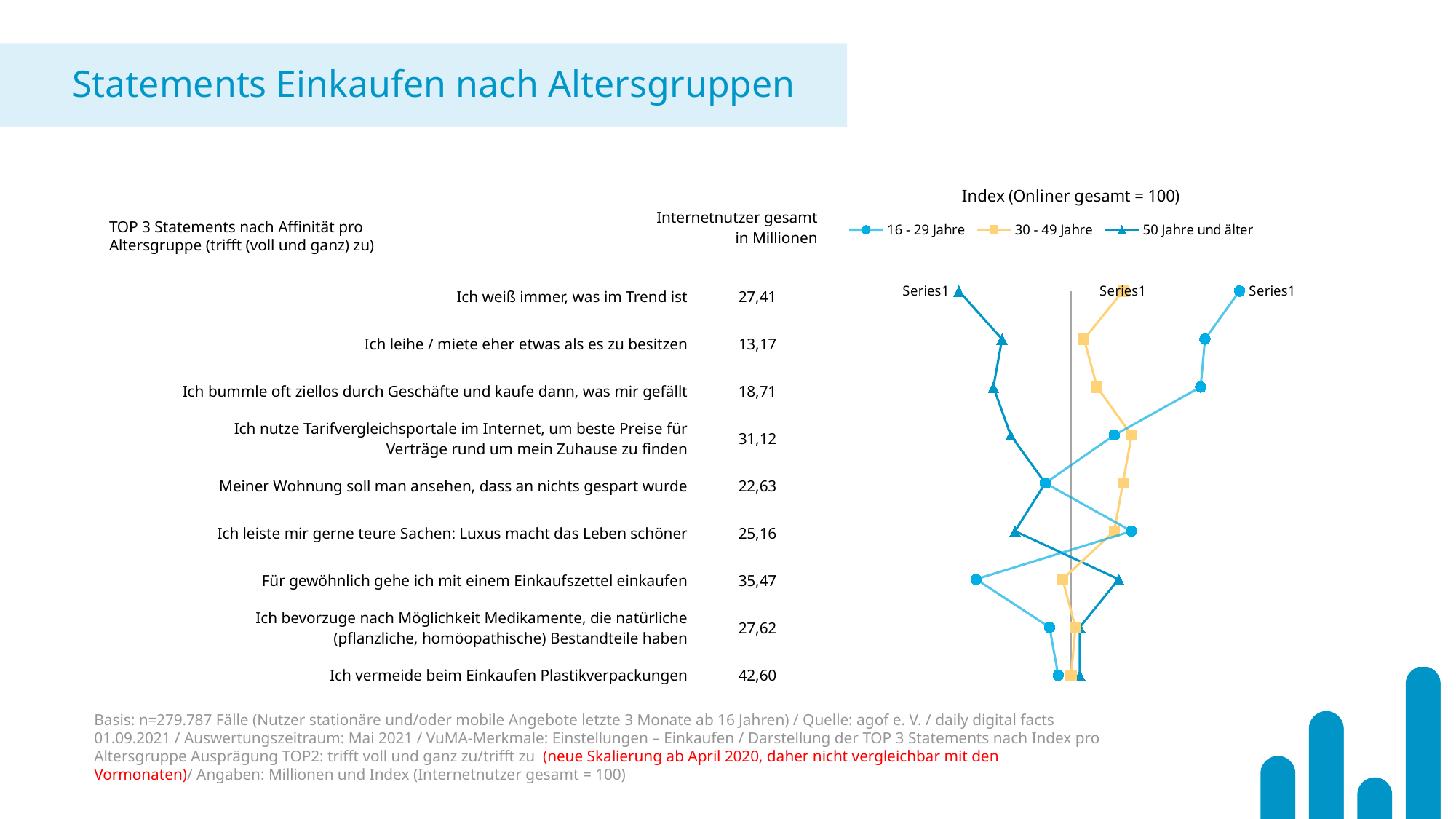
How many statements are plotted in the chart? 9 Which statement has the highest value for Internetnutzer gesamt in Millionen? Ich vermeide beim Einkaufen Plastikverpackungen What kind of chart is shown on the slide? line chart Which statement has the lowest value for Internetnutzer gesamt in Millionen? Ich leihe / miete eher etwas als es zu besitzen What is the value in millions (Internetnutzer gesamt) for "Ich nutze Tarifvergleichsportale im Internet, um beste Preise für Verträge rund um mein Zuhause zu finden"? 31,12 For the statement "Für gewöhnlich gehe ich mit einem Einkaufszettel einkaufen", is the index for 16 - 29 Jahre greater or less than 100? less How many series does the chart legend list? 3 What is the value in millions (Internetnutzer gesamt) for "Ich vermeide beim Einkaufen Plastikverpackungen"? 42,60 What is the title shown above the chart legend? Index (Onliner gesamt = 100) For the statement "Ich weiß immer, was im Trend ist", which age group has the highest index? 16 - 29 Jahre Which age groups are listed in the chart legend? 16 - 29 Jahre, 30 - 49 Jahre, 50 Jahre und älter What is the difference in millions between "Für gewöhnlich gehe ich mit einem Einkaufszettel einkaufen" and "Ich leiste mir gerne teure Sachen: Luxus macht das Leben schöner"? 10,31